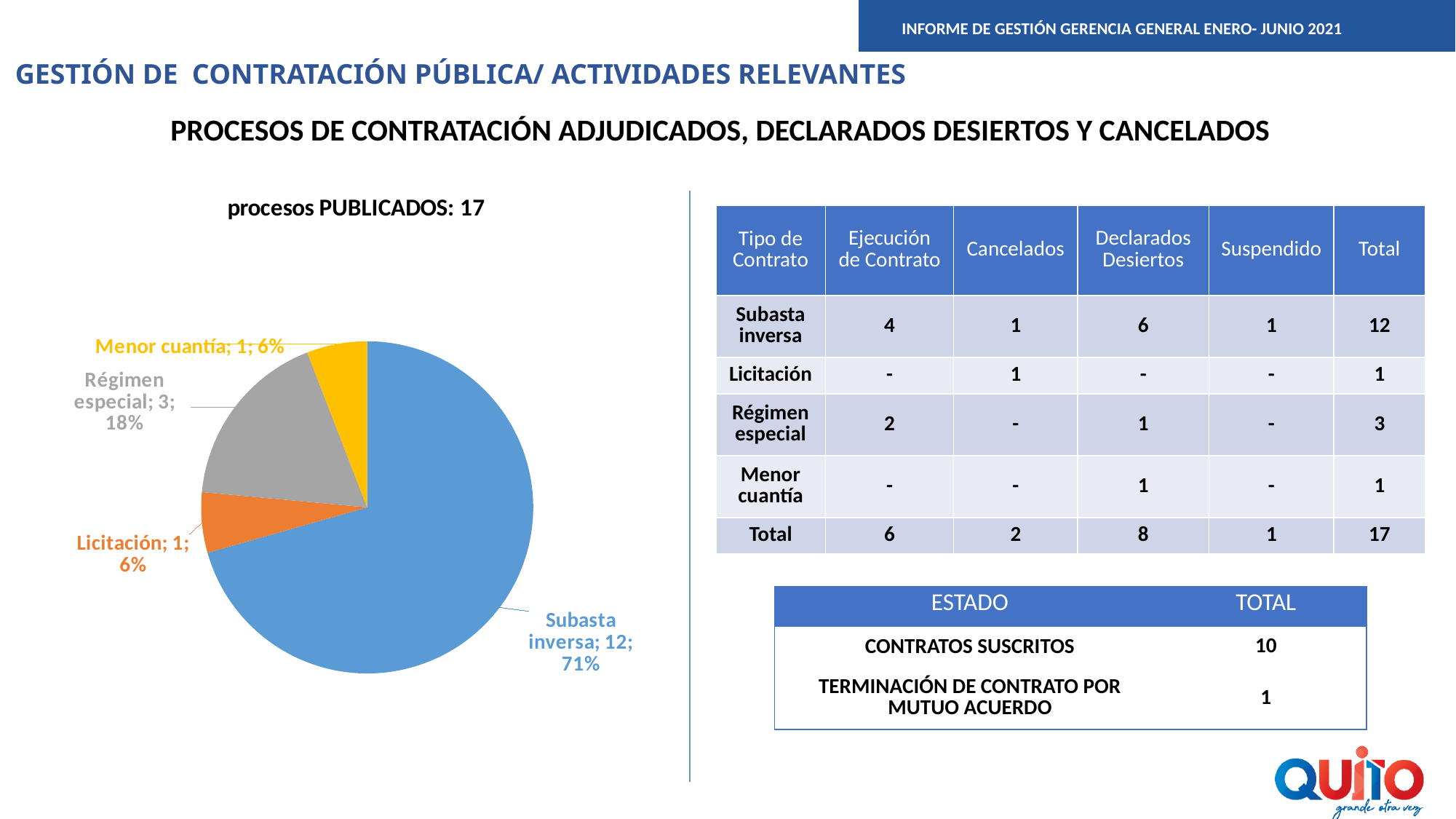
Which is larger in the pie chart, Régimen especial or Licitación? Régimen especial What kind of chart is shown on the slide? pie chart Which category has the largest slice in the pie chart? Subasta inversa What share of the pie does Menor cuantía represent? 6% What is the value for Licitación in the pie chart? 1 What is the title of the pie chart? procesos PUBLICADOS: 17 What share of the pie does Régimen especial represent? 18% What is the difference between the values for Subasta inversa and Régimen especial in the pie chart? 9 What is the value for Subasta inversa in the pie chart? 12 What share of the pie does Subasta inversa represent? 71% How many slices does the pie chart have? 4 What is the value for Régimen especial in the pie chart? 3